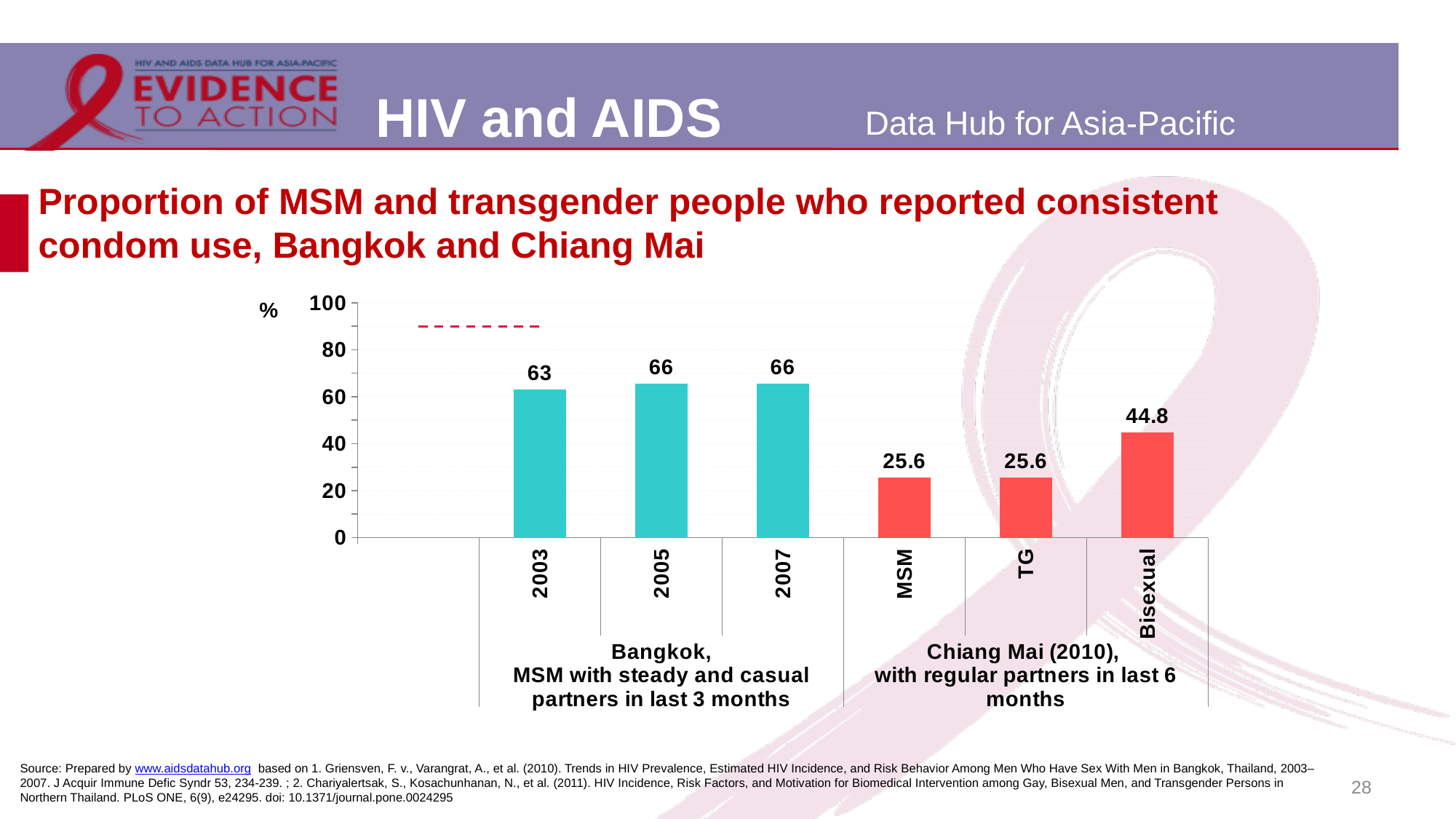
What is the value for TG in the Chiang Mai (2010) group? 25.6 Do the Bangkok values rise or fall from 2003 to 2005? Rise Which is larger, the value for 2007 in Bangkok or the value for Bisexual in Chiang Mai? 2007 in Bangkok What kind of chart is shown on the slide? Bar chart What unit is shown on the y axis of the chart? % Is the value for Bisexual in Chiang Mai greater or less than 40? greater What is the difference between the Bisexual value and the MSM value in the Chiang Mai (2010) group? 19.2 How many bars are plotted on the chart? 6 What is the difference between the 2005 and 2003 values for Bangkok? 3 What is the value for 2003 in the Bangkok group? 63 What is the value for Bisexual in the Chiang Mai (2010) group? 44.8 Which category has the lowest value on the chart? MSM and TG (both 25.6)